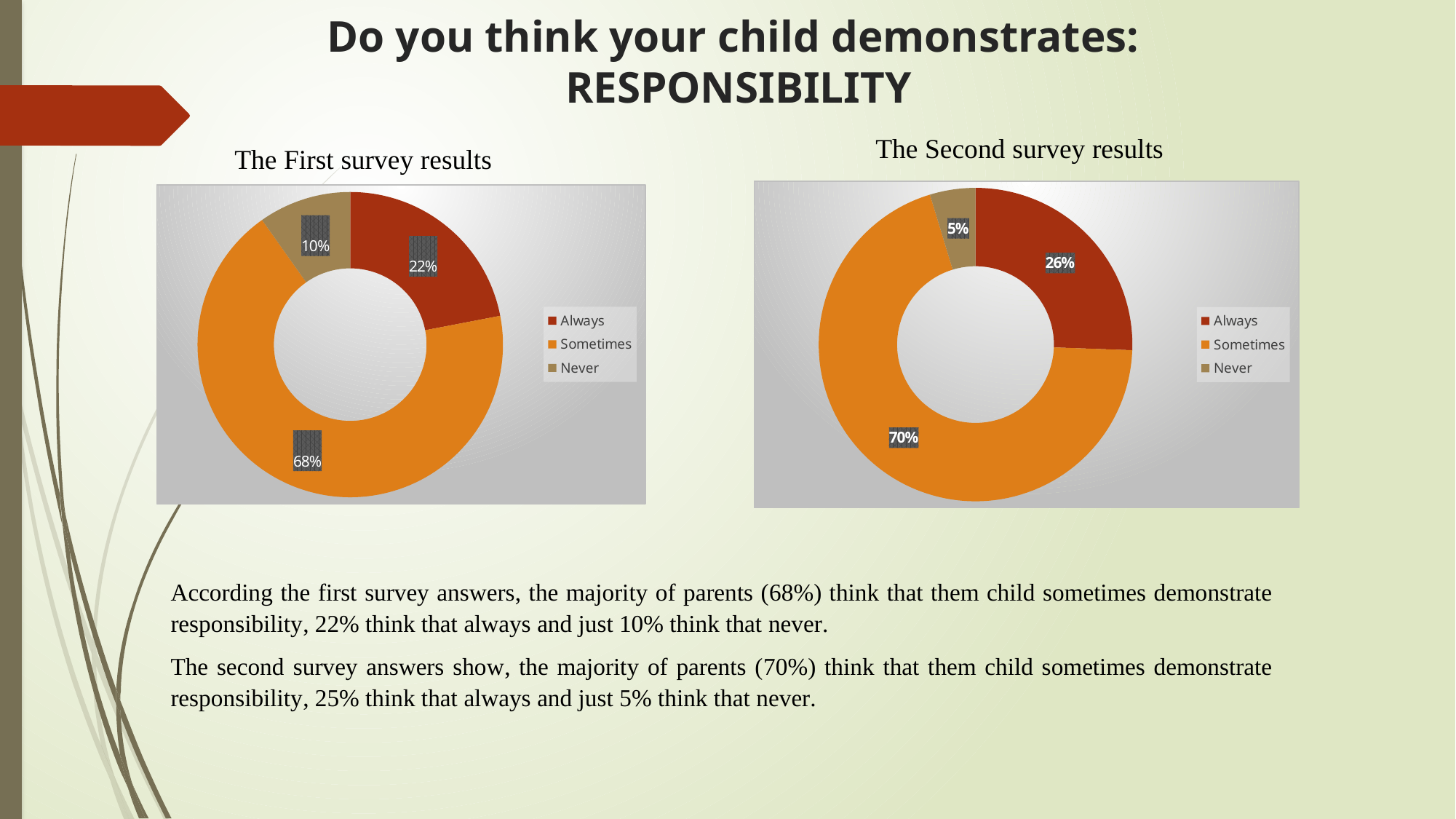
In the Second survey results chart, what percentage of parents answered Always? 26% In the Second survey results chart, what percentage of parents answered Never? 5% How many categories does the legend of the First survey results chart list? 3 In the Second survey results chart, what is the difference between the Sometimes and Always shares? 44% In the First survey results chart, which category has the largest share? Sometimes In the First survey results chart, what is the difference between the Always and Never shares? 12% In the Second survey results chart, which colour represents Sometimes? Orange In the First survey results chart, what percentage of parents answered Never? 10% In the First survey results chart, what percentage of parents answered Sometimes? 68% In the Second survey results chart, which category has the smallest share? Never What kind of chart is the Second survey results chart? Doughnut chart Is the Always share larger in the First survey results chart or the Second survey results chart? The Second survey results chart